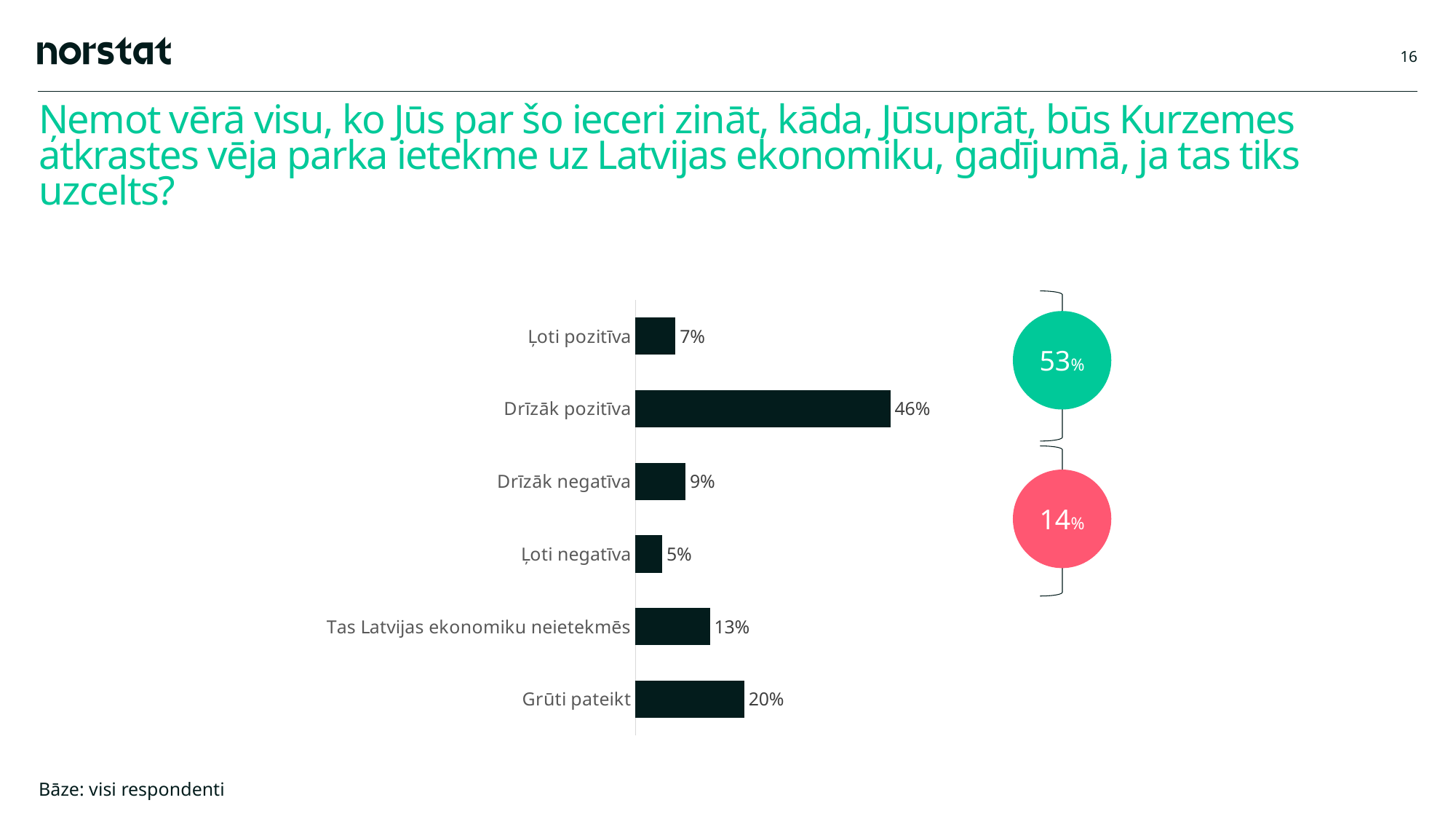
What is the value for Grūti pateikt? 20% Which category has the highest value? Drīzāk pozitīva What is the value for Tas Latvijas ekonomiku neietekmēs? 13% What is the value for Ļoti negatīva? 5% What percentage is shown in the red circle on the right? 14% What is the difference between Drīzāk pozitīva and Drīzāk negatīva? 37% Which category has the lowest value? Ļoti negatīva How many categories are shown in the bar chart? 6 What kind of chart is shown on the slide? Bar chart What percentage is shown in the green circle on the right? 53% Which is larger, Ļoti pozitīva or Drīzāk negatīva? Drīzāk negatīva What is the value for Drīzāk pozitīva? 46%